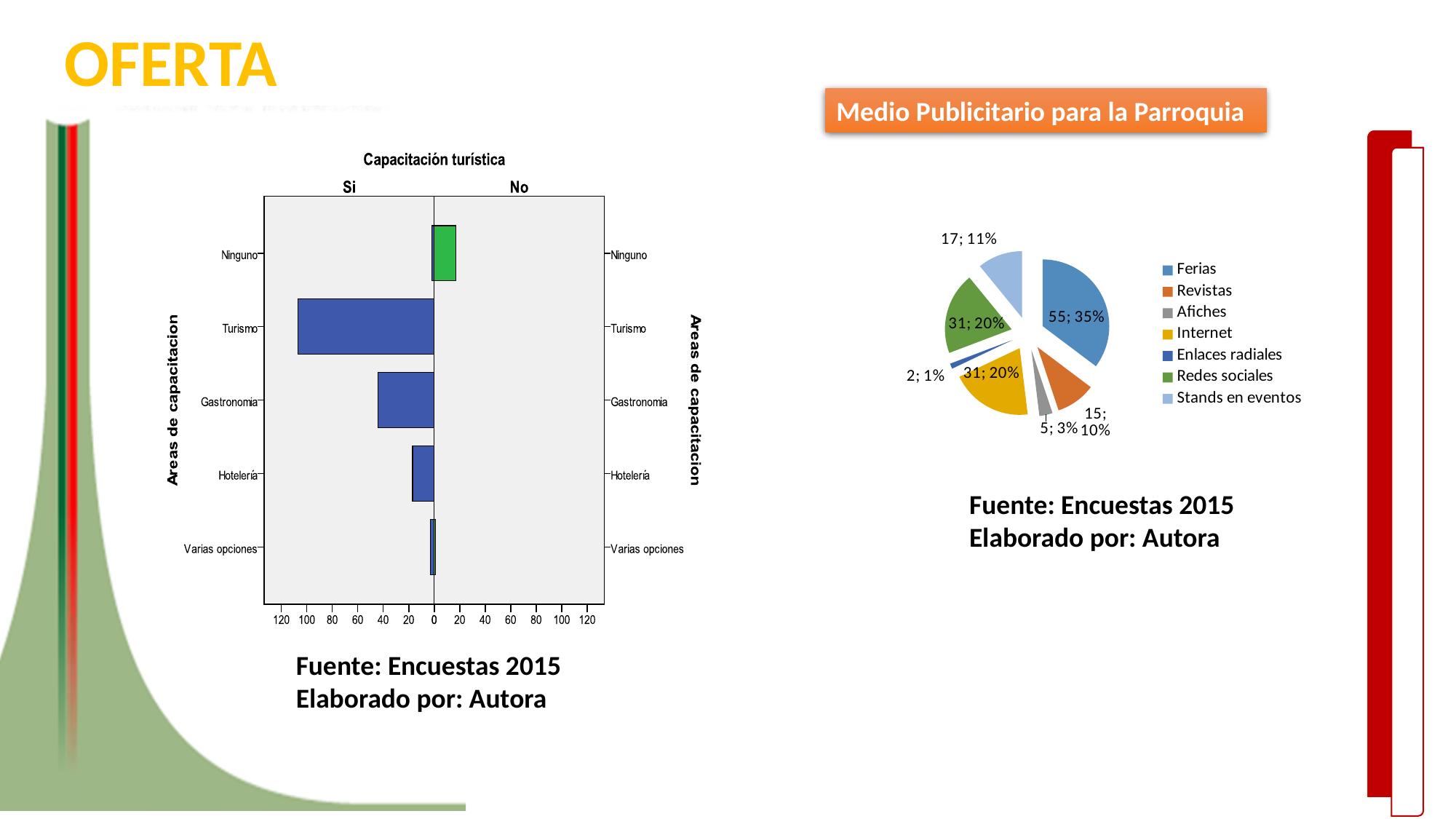
What kind of chart is the 'Capacitación turística' chart on the left of the slide? Bar chart In the 'Medio Publicitario para la Parroquia' pie chart, what is the difference between the values for Ferias and Revistas? 40 In the 'Capacitación turística' chart, which area has the longest 'Si' bar? Turismo In the 'Capacitación turística' chart, is the 'Si' value for Hotelería greater or less than 40? less In the 'Medio Publicitario para la Parroquia' pie chart, which category has the smallest slice? Enlaces radiales In the 'Capacitación turística' chart, is the 'Si' value for Turismo greater or less than 100? greater In the 'Medio Publicitario para la Parroquia' pie chart, what value and percentage are shown for Ferias? 55; 35% In the 'Medio Publicitario para la Parroquia' pie chart, which category has the largest slice? Ferias In the 'Medio Publicitario para la Parroquia' pie chart, which is larger, Stands en eventos or Afiches? Stands en eventos In the 'Medio Publicitario para la Parroquia' pie chart, what value and percentage are shown for Enlaces radiales? 2; 1% How many entries does the legend of the 'Medio Publicitario para la Parroquia' pie chart list? 7 What share of the 'Medio Publicitario para la Parroquia' pie does Internet represent? 20%